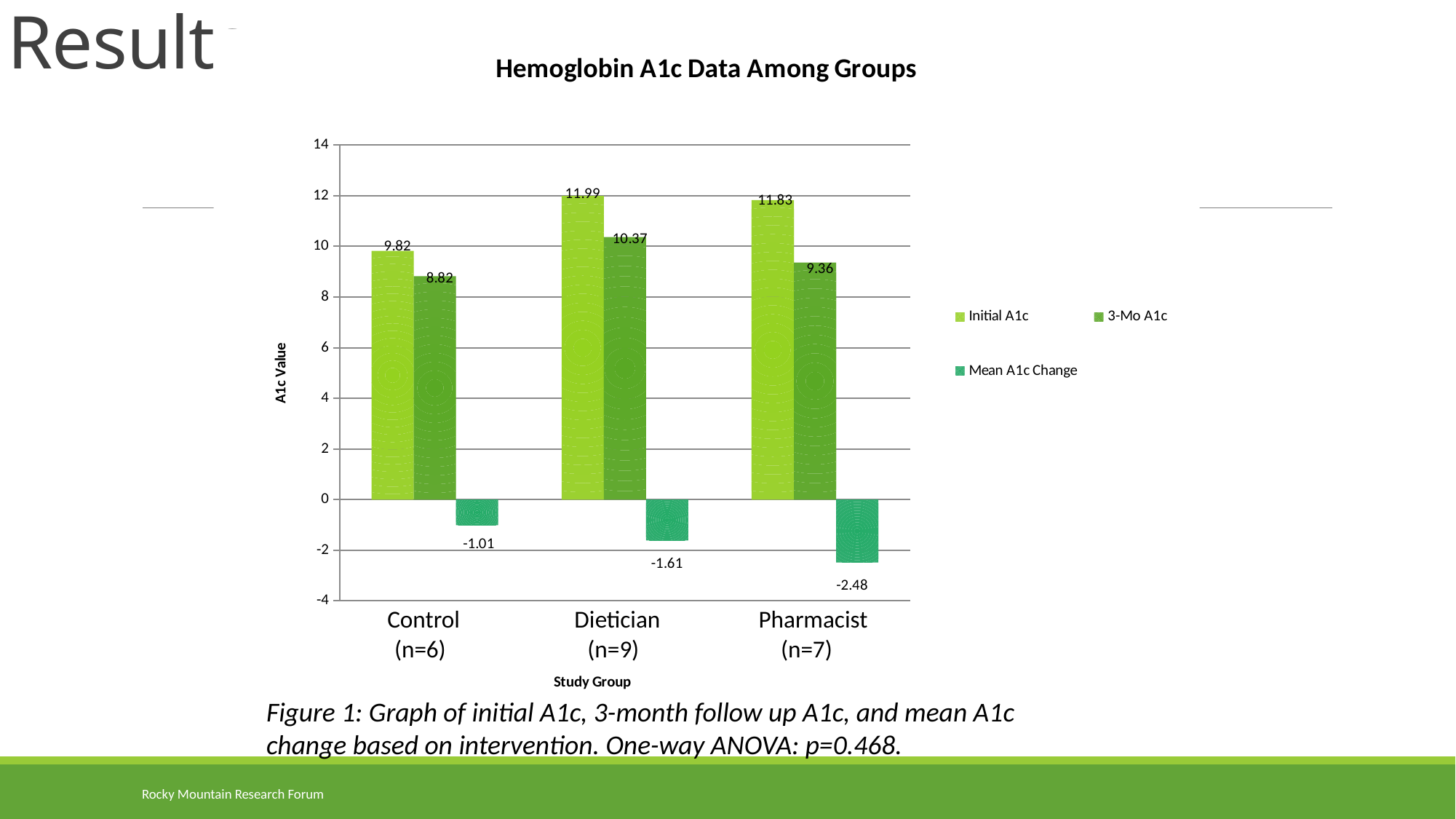
Which study group has the lowest 3-Mo A1c value? Control (n=6) Which is larger: the 3-Mo A1c value for the Dietician (n=9) group or the 3-Mo A1c value for the Pharmacist (n=7) group? Dietician (n=9) What is the difference between the Initial A1c and 3-Mo A1c values for the Pharmacist (n=7) group? 2.47 What kind of chart is shown on the slide? bar chart What is the title of the chart? Hemoglobin A1c Data Among Groups Is the Initial A1c value for the Control (n=6) group greater or less than 10? less How many series does the legend list? 3 What is the 3-Mo A1c value for the Dietician (n=9) group? 10.37 What is the Mean A1c Change for the Pharmacist (n=7) group? -2.48 Which study group has the highest Initial A1c value? Dietician (n=9) What is the Initial A1c value for the Control (n=6) group? 9.82 How many study groups are shown on the x axis? 3